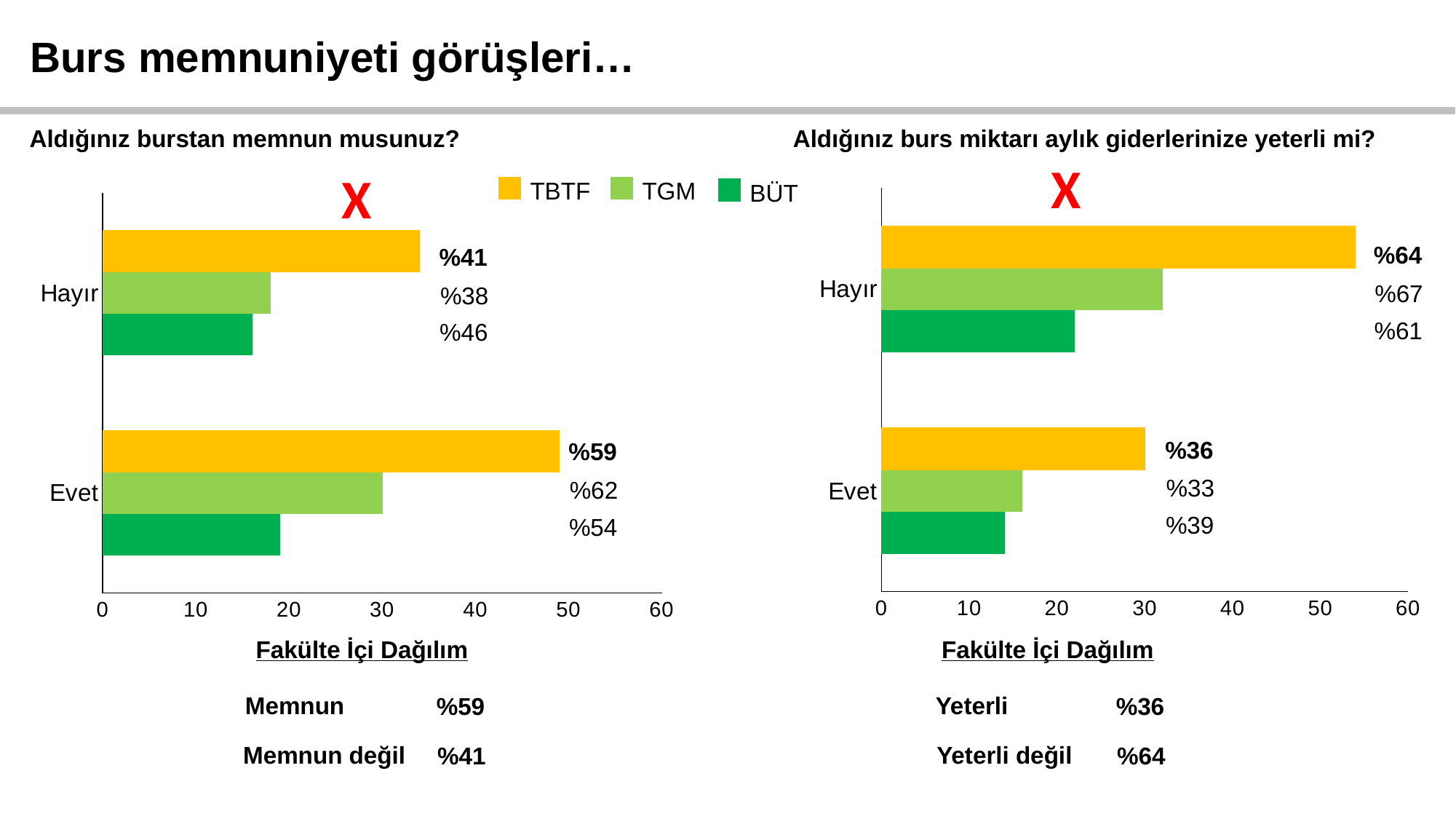
How many series does the legend list? 3 In the right chart (Aldığınız burs miktarı aylık giderlerinize yeterli mi?), what is the value for TBTF in the Evet category? %36 In the right chart (Aldığınız burs miktarı aylık giderlerinize yeterli mi?), what is the value for BÜT in the Hayır category? %61 How many categories are shown on the left chart (Aldığınız burstan memnun musunuz?)? 2 In the left chart (Aldığınız burstan memnun musunuz?), what is the value for TGM in the Evet category? %62 What kind of chart is the right chart (Aldığınız burs miktarı aylık giderlerinize yeterli mi?)? Bar chart In the left chart (Aldığınız burstan memnun musunuz?), what is the value for TBTF in the Hayır category? %41